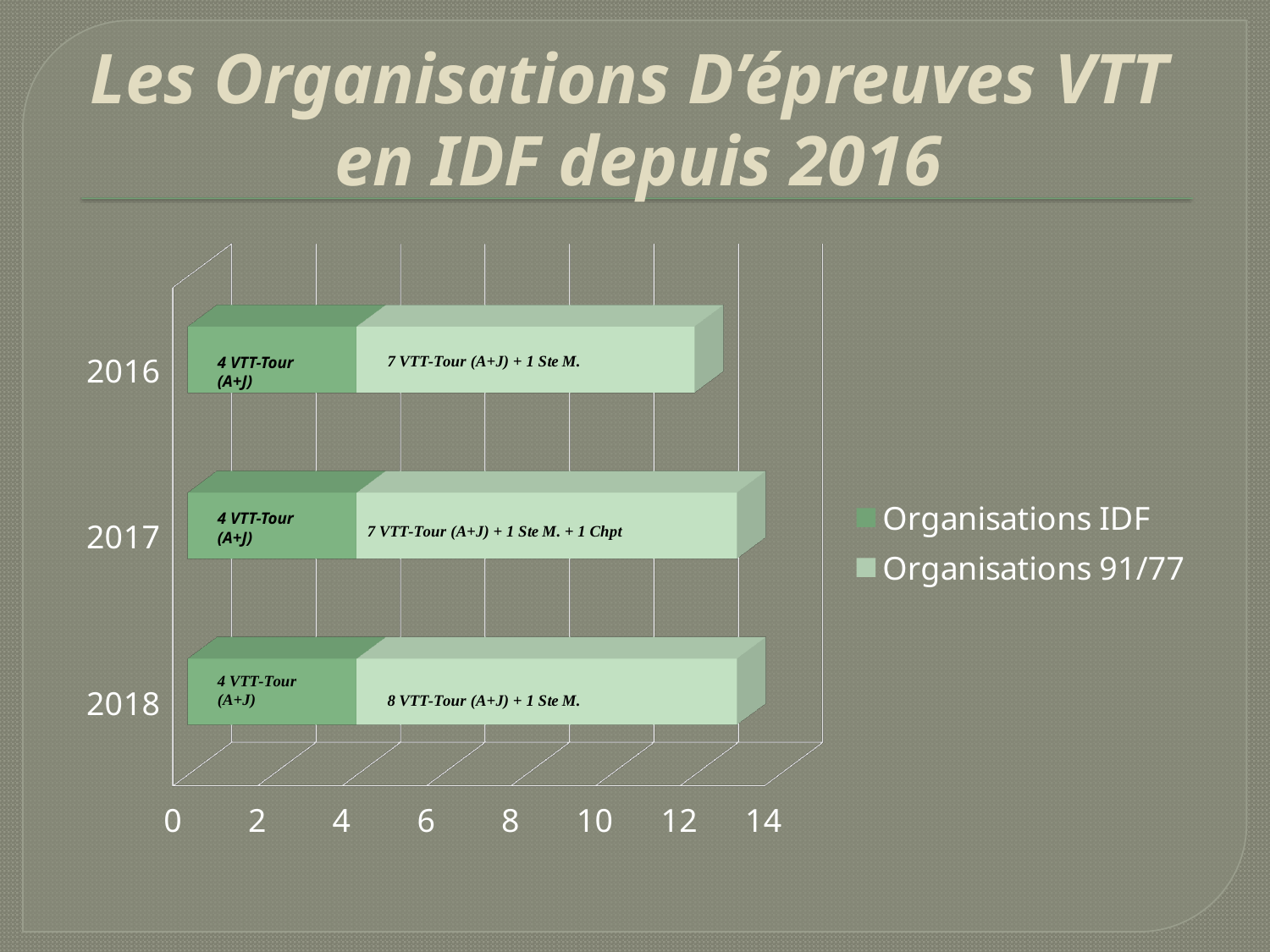
How many years (categories) are shown on the chart? 3 Is the total length of the stacked bar for 2017 greater or less than 14? less What is the data label on the Organisations 91/77 segment for 2018? 8 VTT-Tour (A+J) + 1 Ste M. What kind of chart is shown on the slide? bar chart Is the value for Organisations IDF in 2018 greater or less than 6? less What are the two series named in the legend? Organisations IDF; Organisations 91/77 How many series does the legend list? 2 What is the highest value shown on the horizontal axis? 14 Is the total length of the stacked bar for 2016 greater or less than 10? greater What is the data label on the Organisations 91/77 segment for 2016? 7 VTT-Tour (A+J) + 1 Ste M. What is the data label on the Organisations 91/77 segment for 2017? 7 VTT-Tour (A+J) + 1 Ste M. + 1 Chpt What is the data label on the Organisations IDF segment for 2016? 4 VTT-Tour (A+J)